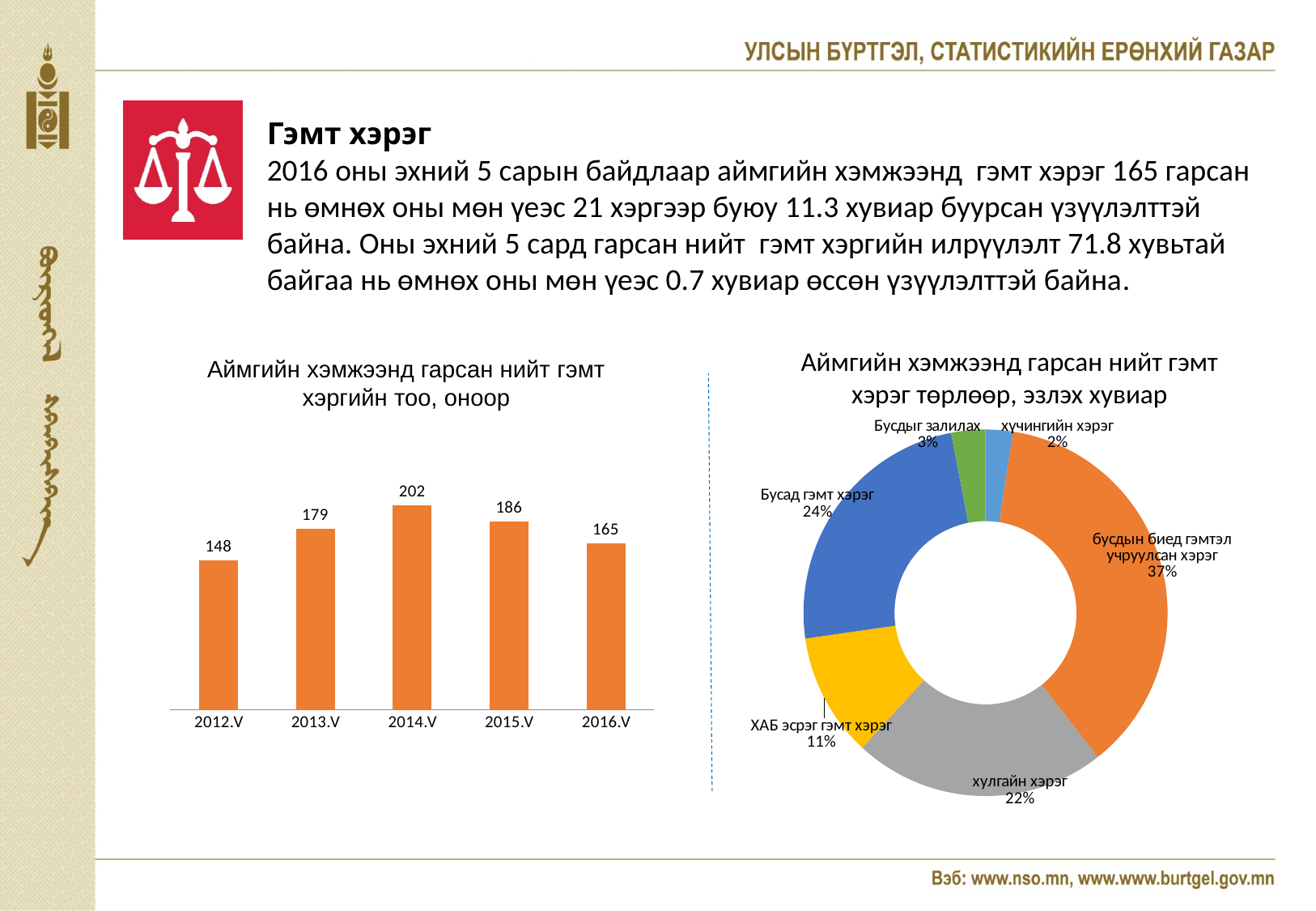
In the left chart (Аймгийн хэмжээнд гарсан нийт гэмт хэргийн тоо, оноор), which is larger, the value for 2013.V or 2015.V? 2015.V In the left chart (Аймгийн хэмжээнд гарсан нийт гэмт хэргийн тоо, оноор), what is the difference between the values for 2015.V and 2016.V? 21 In the left chart (Аймгийн хэмжээнд гарсан нийт гэмт хэргийн тоо, оноор), which year has the highest value? 2014.V In the left chart (Аймгийн хэмжээнд гарсан нийт гэмт хэргийн тоо, оноор), what is the value for 2012.V? 148 What kind of chart is the left chart (Аймгийн хэмжээнд гарсан нийт гэмт хэргийн тоо, оноор)? Bar chart In the left chart (Аймгийн хэмжээнд гарсан нийт гэмт хэргийн тоо, оноор), how many years are shown? 5 In the right chart (Аймгийн хэмжээнд гарсан нийт гэмт хэрэг төрлөөр, эзлэх хувиар), which category has the smallest share? хүчингийн хэрэг In the left chart (Аймгийн хэмжээнд гарсан нийт гэмт хэргийн тоо, оноор), what is the value for 2014.V? 202 In the right chart (Аймгийн хэмжээнд гарсан нийт гэмт хэрэг төрлөөр, эзлэх хувиар), what share does бусдын биед гэмтэл учруулсан хэрэг have? 37% In the left chart (Аймгийн хэмжээнд гарсан нийт гэмт хэргийн тоо, оноор), do the values rise or fall from 2014.V to 2016.V? Fall In the left chart (Аймгийн хэмжээнд гарсан нийт гэмт хэргийн тоо, оноор), which year has the lowest value? 2012.V In the right chart (Аймгийн хэмжээнд гарсан нийт гэмт хэрэг төрлөөр, эзлэх хувиар), how many categories are shown? 6